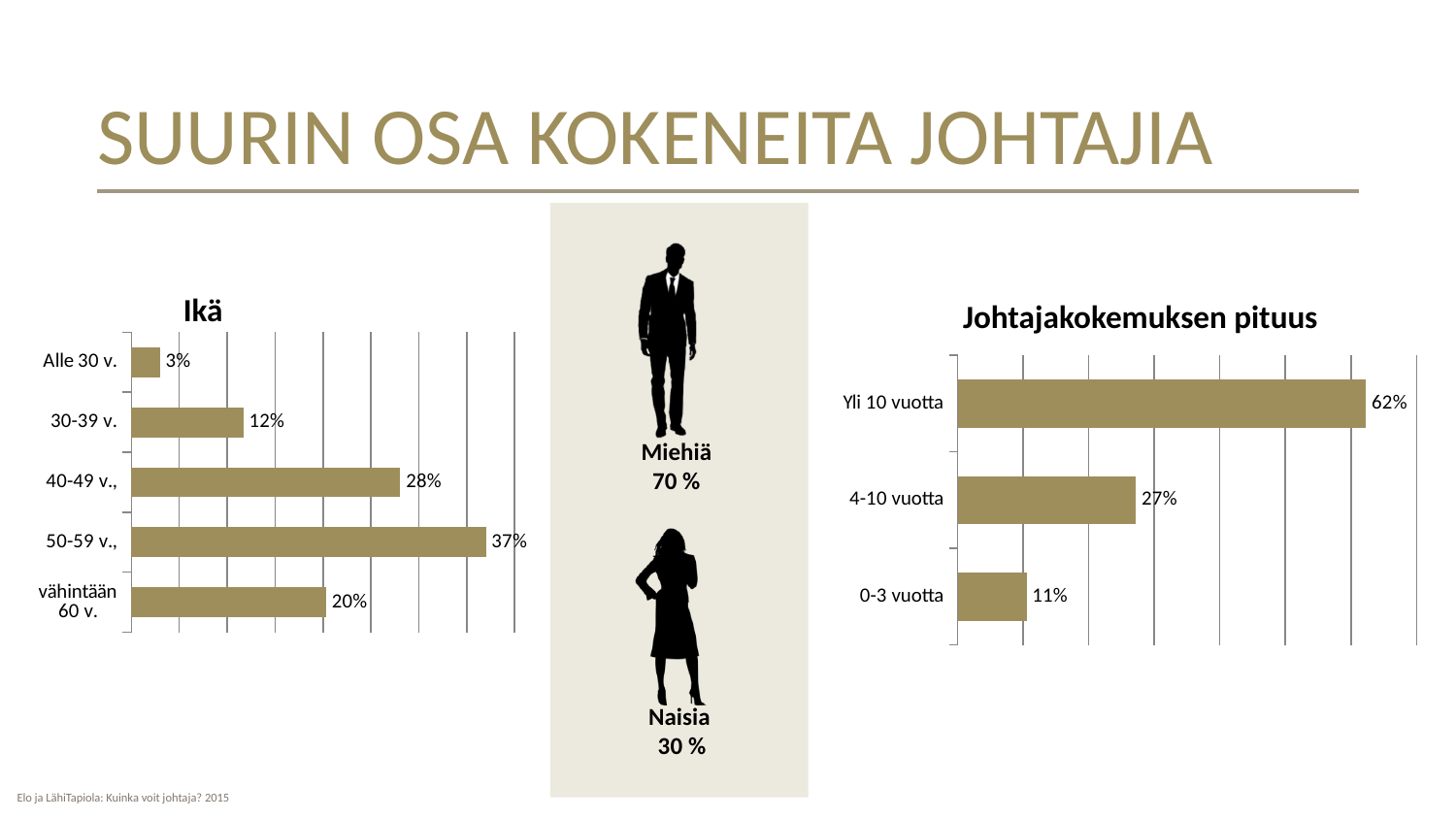
In the "Ikä" chart, what is the difference between the values for 50-59 v. and 30-39 v.? 25% In the "Ikä" chart, what is the value for 40-49 v.? 28% In the "Ikä" chart, what is the value for vähintään 60 v.? 20% In the "Johtajakokemuksen pituus" chart, what is the difference between Yli 10 vuotta and 4-10 vuotta? 35% In the "Ikä" chart, which age category has the highest value? 50-59 v. In the "Johtajakokemuksen pituus" chart, how many categories are shown? 3 In the "Ikä" chart, how many age categories are shown? 5 In the "Johtajakokemuksen pituus" chart, which category has the lowest value? 0-3 vuotta What kind of chart is the "Johtajakokemuksen pituus" chart? Bar chart In the "Johtajakokemuksen pituus" chart, which is larger: 4-10 vuotta or 0-3 vuotta? 4-10 vuotta In the "Johtajakokemuksen pituus" chart, what is the value for Yli 10 vuotta? 62% In the "Ikä" chart, which age category has the lowest value? Alle 30 v.